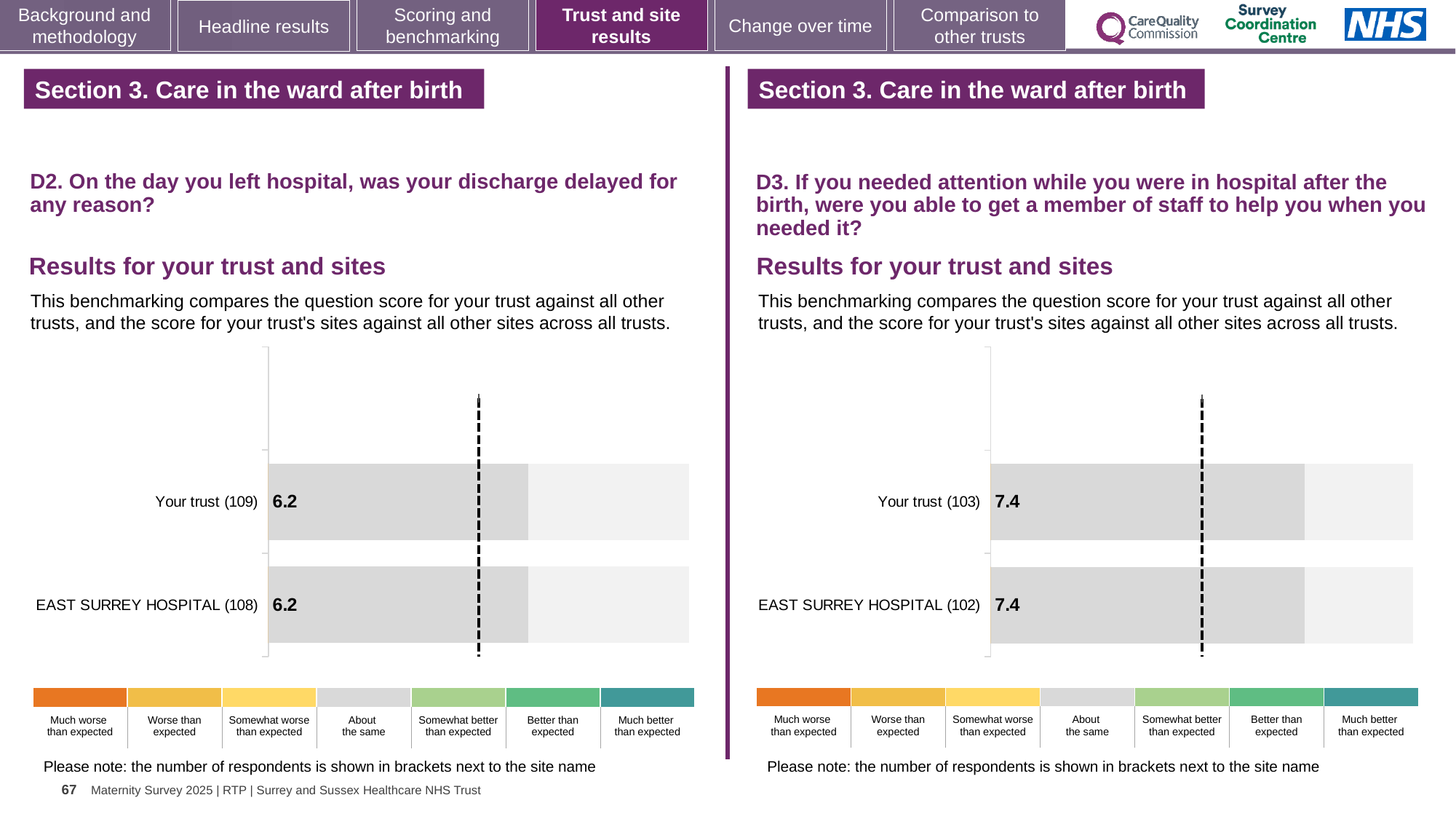
How many bars are plotted in the right chart (D3)? 2 In the left chart (D2), how many respondents are shown in brackets next to EAST SURREY HOSPITAL? 108 In the left chart (D2, discharge delayed), what is the score for Your trust? 6.2 In the right chart (D3), which benchmark category does the colour of the bars correspond to according to the legend? About the same In the left chart (D2, discharge delayed), what is the score for EAST SURREY HOSPITAL? 6.2 In the right chart (D3, able to get a member of staff to help), what is the score for Your trust? 7.4 What kind of chart is used on the left side of the slide for question D2? Bar chart In the right chart (D3), what is the difference between the score for Your trust and the score for EAST SURREY HOSPITAL? 0.0 How many bars are plotted in the left chart (D2)? 2 In the right chart (D3, able to get a member of staff to help), what is the score for EAST SURREY HOSPITAL? 7.4 In the left chart (D2), what is the difference between the score for Your trust and the score for EAST SURREY HOSPITAL? 0.0